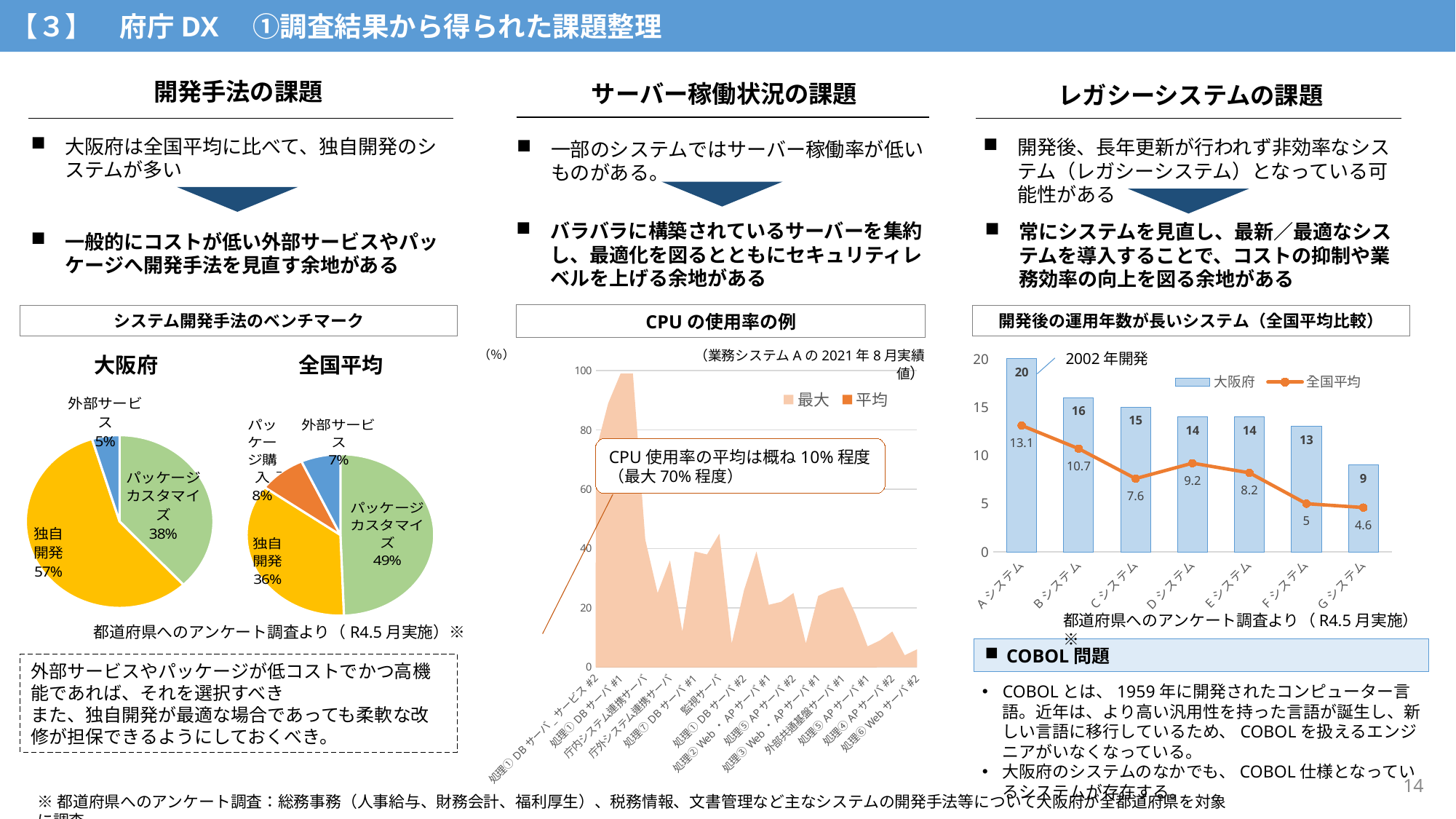
Comparing the two pie charts, is the 独自開発 share larger for 大阪府 or for 全国平均? 大阪府 In the 全国平均 pie chart under システム開発手法のベンチマーク, what share does パッケージカスタマイズ have? 49% In the 大阪府 pie chart, which category has the smallest share? 外部サービス In the 大阪府 pie chart under システム開発手法のベンチマーク, what share does 独自開発 have? 57% What kind of chart is the CPU の使用率の例 chart? area chart In the chart titled 開発後の運用年数が長いシステム（全国平均比較）, which system has the lowest 大阪府 value? G システム In the chart titled CPU の使用率の例, how many series does the legend list? 2 In the 全国平均 pie chart, how many slices are there? 4 In the chart titled 開発後の運用年数が長いシステム（全国平均比較）, what is the difference between the 大阪府 and 全国平均 values for B システム? 5.3 In the chart titled 開発後の運用年数が長いシステム（全国平均比較）, what is the 全国平均 value for C システム? 7.6 What is the difference between the 独自開発 share in the 大阪府 pie chart and in the 全国平均 pie chart? 21% In the chart titled 開発後の運用年数が長いシステム（全国平均比較）, what is the 大阪府 value for A システム? 20